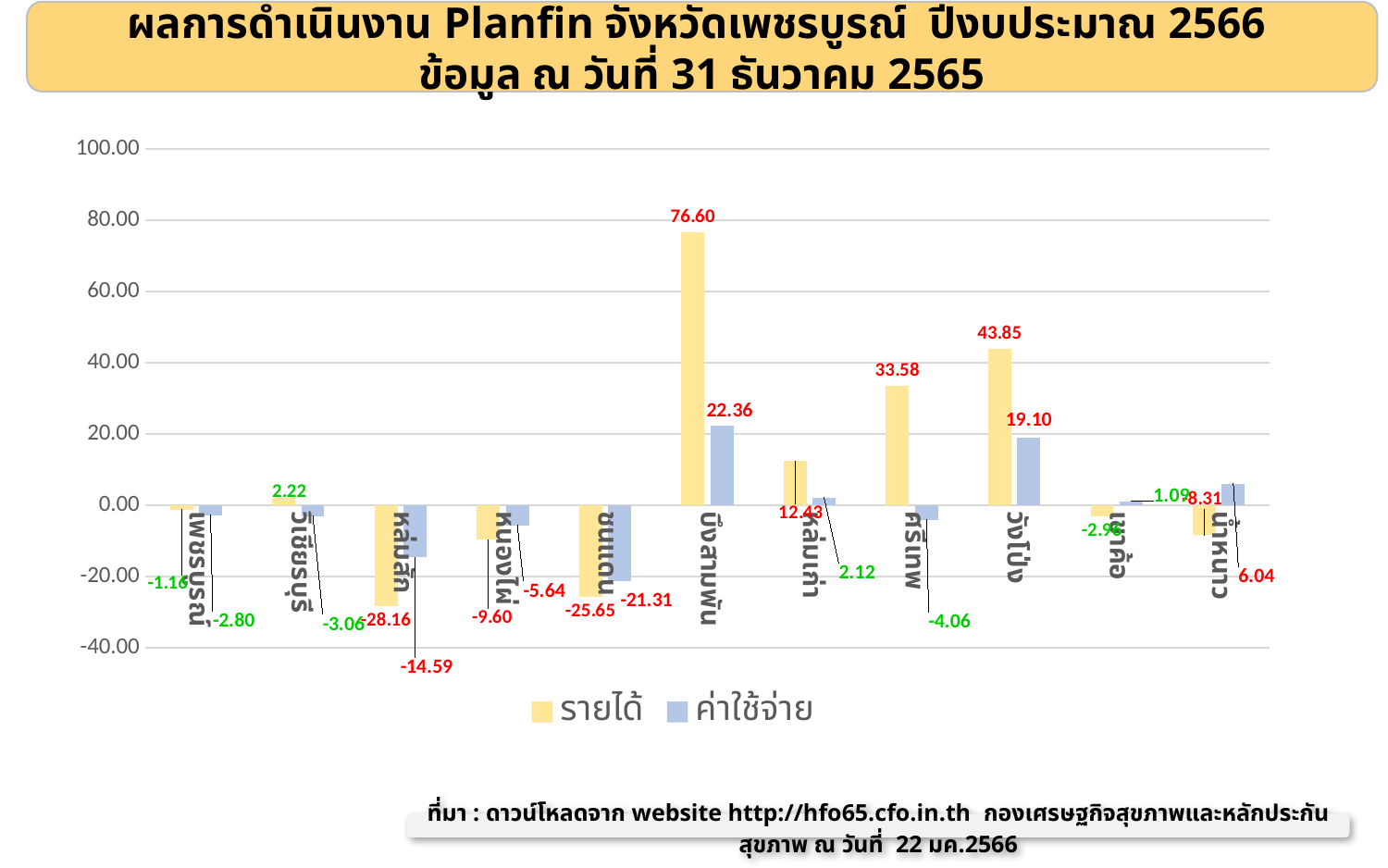
Which category has the lowest รายได้ value? หล่มสัก What is the รายได้ value for บึงสามพัน? 76.60 Is the รายได้ value for บึงสามพัน greater or less than 60.00? greater What is the difference between the รายได้ and ค่าใช้จ่าย values for บึงสามพัน? 54.24 What is the ค่าใช้จ่าย value for วังโป่ง? 19.10 What is the ค่าใช้จ่าย value for ชนแดน? -21.31 How many series does the legend list? 2 What are the two series named in the legend? รายได้ and ค่าใช้จ่าย Which is larger, the รายได้ value for ศรีเทพ or the รายได้ value for วังโป่ง? วังโป่ง What is the รายได้ value for หล่มสัก? -28.16 What type of chart is shown on the slide? bar chart Which category has the highest รายได้ value? บึงสามพัน